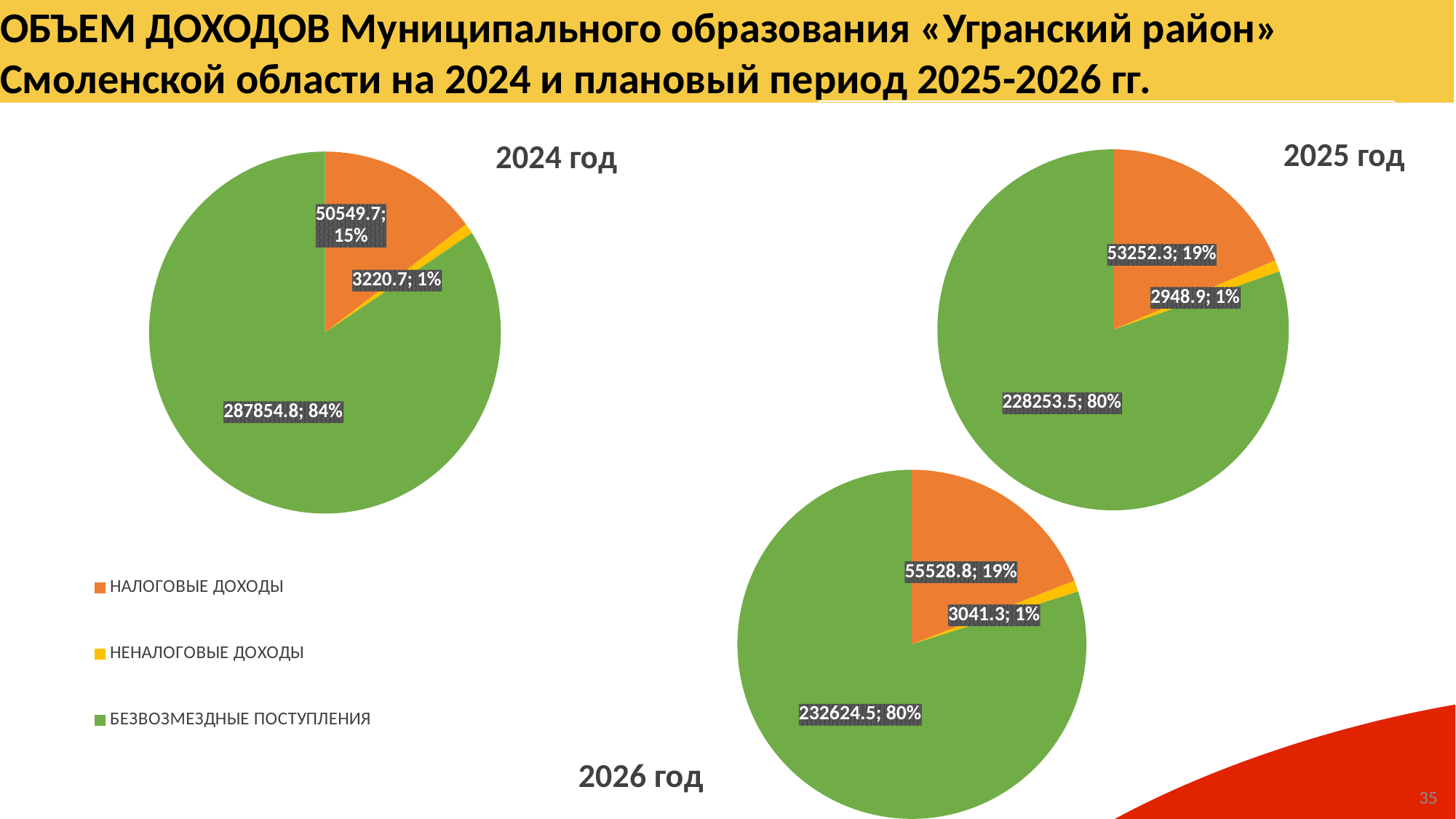
In the 2025 год pie chart, what is the difference between the values for НАЛОГОВЫЕ ДОХОДЫ and НЕНАЛОГОВЫЕ ДОХОДЫ? 50303.4 In the 2026 год pie chart, what is the value shown for БЕЗВОЗМЕЗДНЫЕ ПОСТУПЛЕНИЯ? 232624.5 In the 2026 год pie chart, which category has the smallest slice? НЕНАЛОГОВЫЕ ДОХОДЫ In the 2024 год pie chart, what is the value shown for НАЛОГОВЫЕ ДОХОДЫ? 50549.7 In the 2024 год pie chart, what share of the pie is БЕЗВОЗМЕЗДНЫЕ ПОСТУПЛЕНИЯ? 84% In the 2024 год pie chart, which category has the largest slice? БЕЗВОЗМЕЗДНЫЕ ПОСТУПЛЕНИЯ How many slices does the 2025 год pie chart have? 3 How many categories does the legend list? 3 What type of chart is used for 2024 год? Pie chart Which is larger: the value for НАЛОГОВЫЕ ДОХОДЫ in the 2026 год chart or in the 2024 год chart? 2026 год In the 2025 год pie chart, what is the value shown for НЕНАЛОГОВЫЕ ДОХОДЫ? 2948.9 In the 2025 год pie chart, what share of the pie is НАЛОГОВЫЕ ДОХОДЫ? 19%